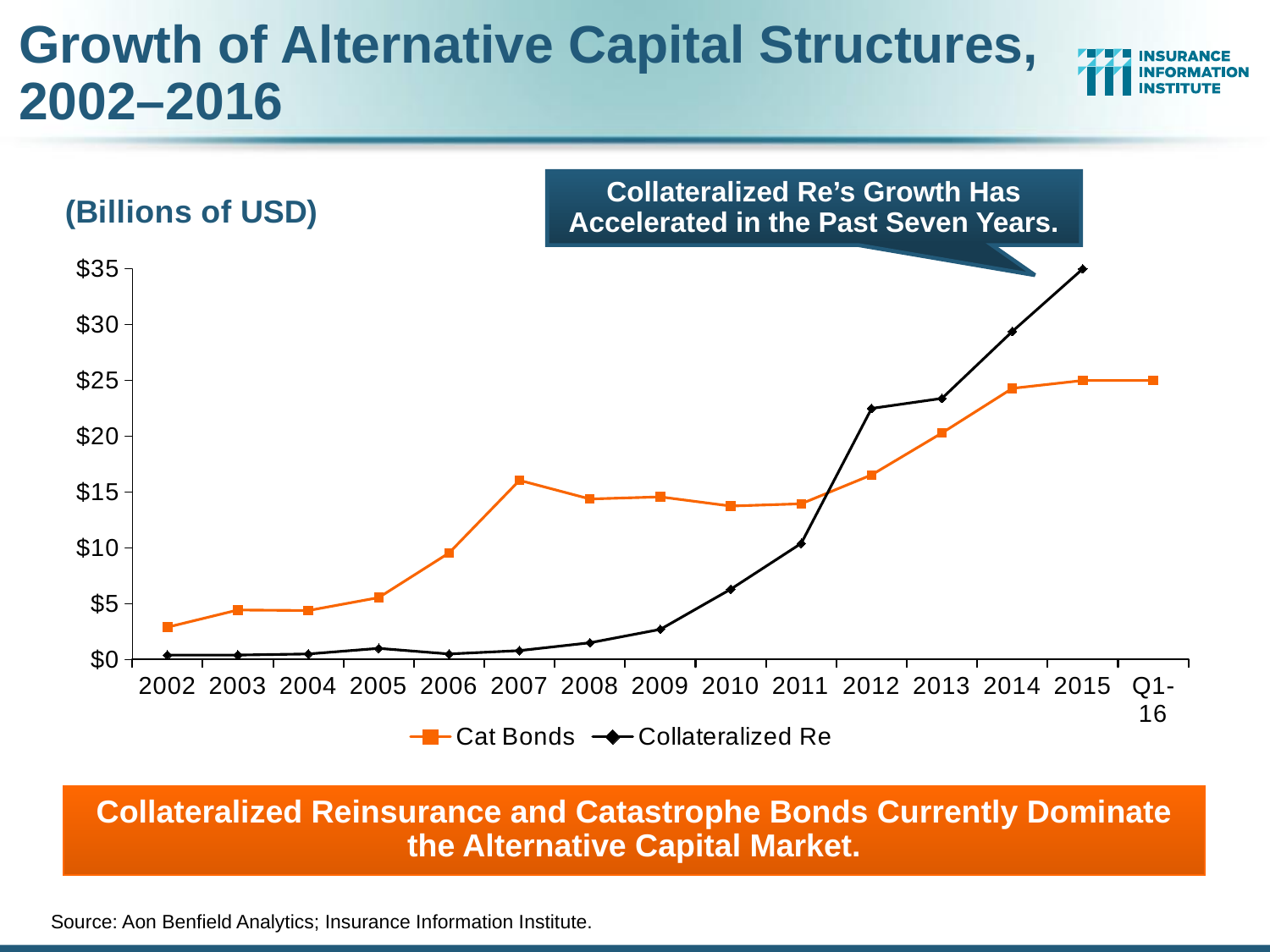
What unit is the y axis measured in, according to the slide? Billions of USD Is the value for Cat Bonds in 2002 greater or less than $5? less At which time point is Collateralized Re at its highest? 2015 Is the value for Collateralized Re in 2012 greater or less than $20? greater How many time points are plotted along the x axis? 15 Is the value for Cat Bonds in 2007 greater or less than $15? greater In which year is Cat Bonds at its lowest? 2002 What kind of chart is shown on the slide? line chart What are the two series named in the legend? Cat Bonds and Collateralized Re In 2014, which series has the larger value, Cat Bonds or Collateralized Re? Collateralized Re How many series does the legend list? 2 In 2011, which series has the larger value, Cat Bonds or Collateralized Re? Cat Bonds